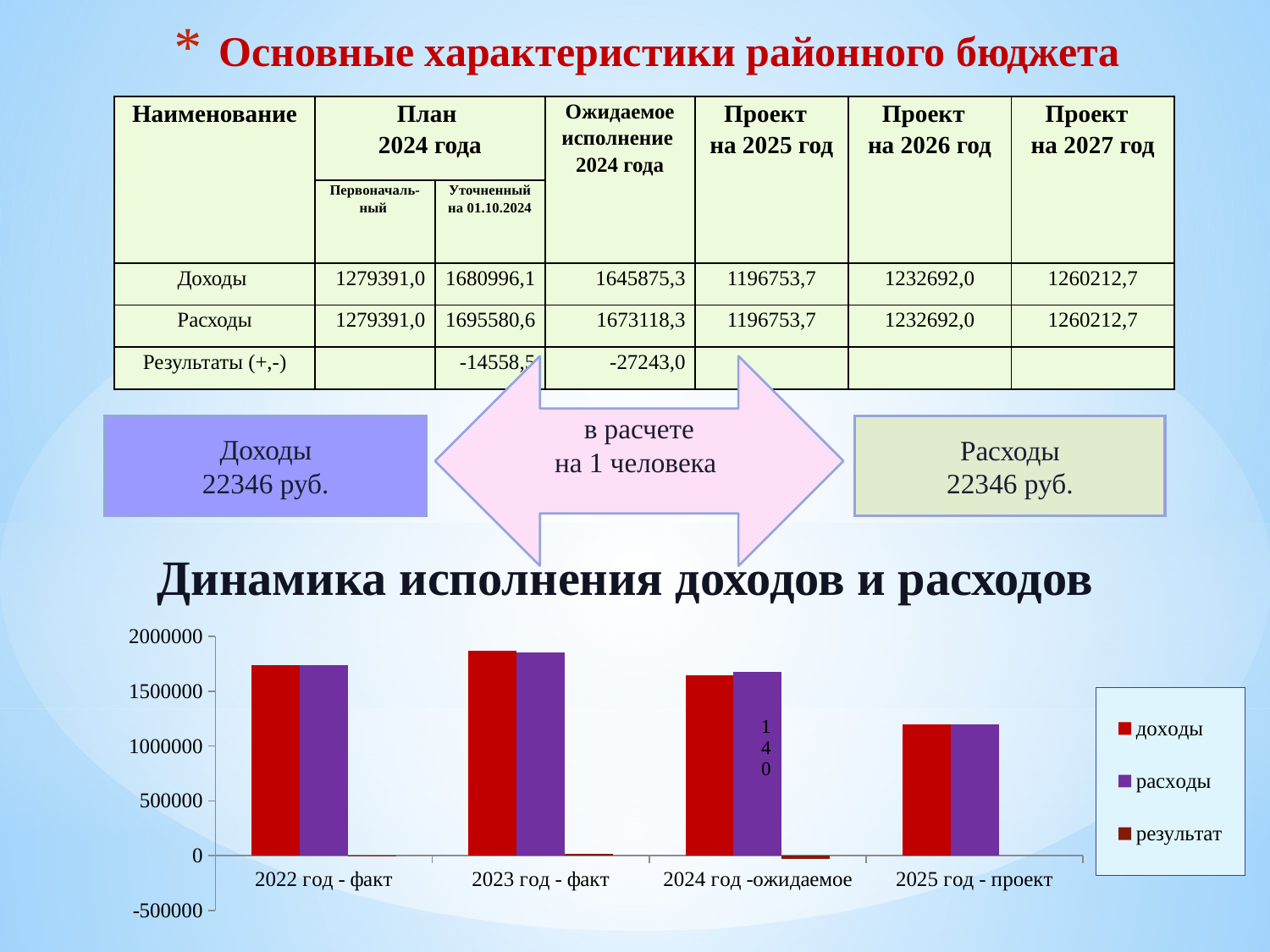
How many categories are shown on the x axis of the chart "Динамика исполнения доходов и расходов"? 4 In the chart "Динамика исполнения доходов и расходов", is the value of доходы for 2023 год - факт greater or less than 1500000? greater In the chart "Динамика исполнения доходов и расходов", which category has the highest value for доходы? 2023 год - факт In the chart "Динамика исполнения доходов и расходов", is the value of расходы for 2022 год - факт greater or less than 1000000? greater What kind of chart is shown under the heading "Динамика исполнения доходов и расходов"? bar chart In the chart "Динамика исполнения доходов и расходов", which category has the lowest value for расходы? 2025 год - проект In the chart "Динамика исполнения доходов и расходов", is the value of доходы for 2025 год - проект greater or less than 1500000? less In the chart "Динамика исполнения доходов и расходов", do the values of расходы rise or fall from 2023 год - факт to 2025 год - проект? fall What is the title of the chart at the bottom of the slide? Динамика исполнения доходов и расходов How many series does the legend of the chart "Динамика исполнения доходов и расходов" list? 3 In the chart "Динамика исполнения доходов и расходов", which is larger: доходы for 2023 год - факт or доходы for 2025 год - проект? 2023 год - факт In the chart "Динамика исполнения доходов и расходов", which series is shown in purple according to the legend? расходы